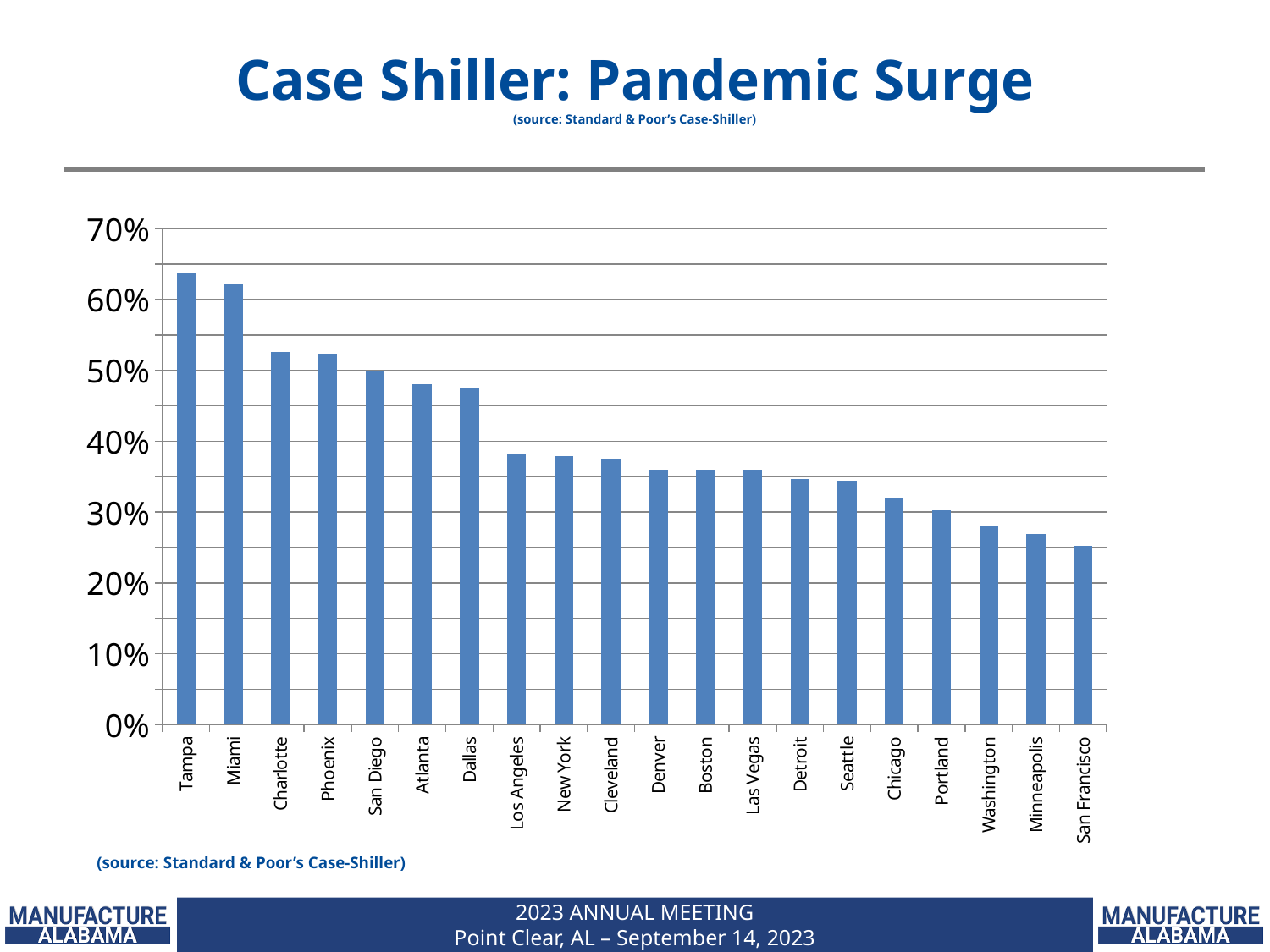
How many cities are shown on the x axis of the chart? 20 Is the value for Charlotte greater or less than 50%? greater Is the value for Washington greater or less than 30%? less What kind of chart is shown on the slide? bar chart Which city has the highest value in the chart? Tampa Is the value for Atlanta greater or less than 50%? less What is the title of the chart on the slide? Case Shiller: Pandemic Surge Which city has the larger value, Charlotte or Dallas? Charlotte Do the values rise or fall moving from left to right along the x axis? fall Which city has the lowest value in the chart? San Francisco